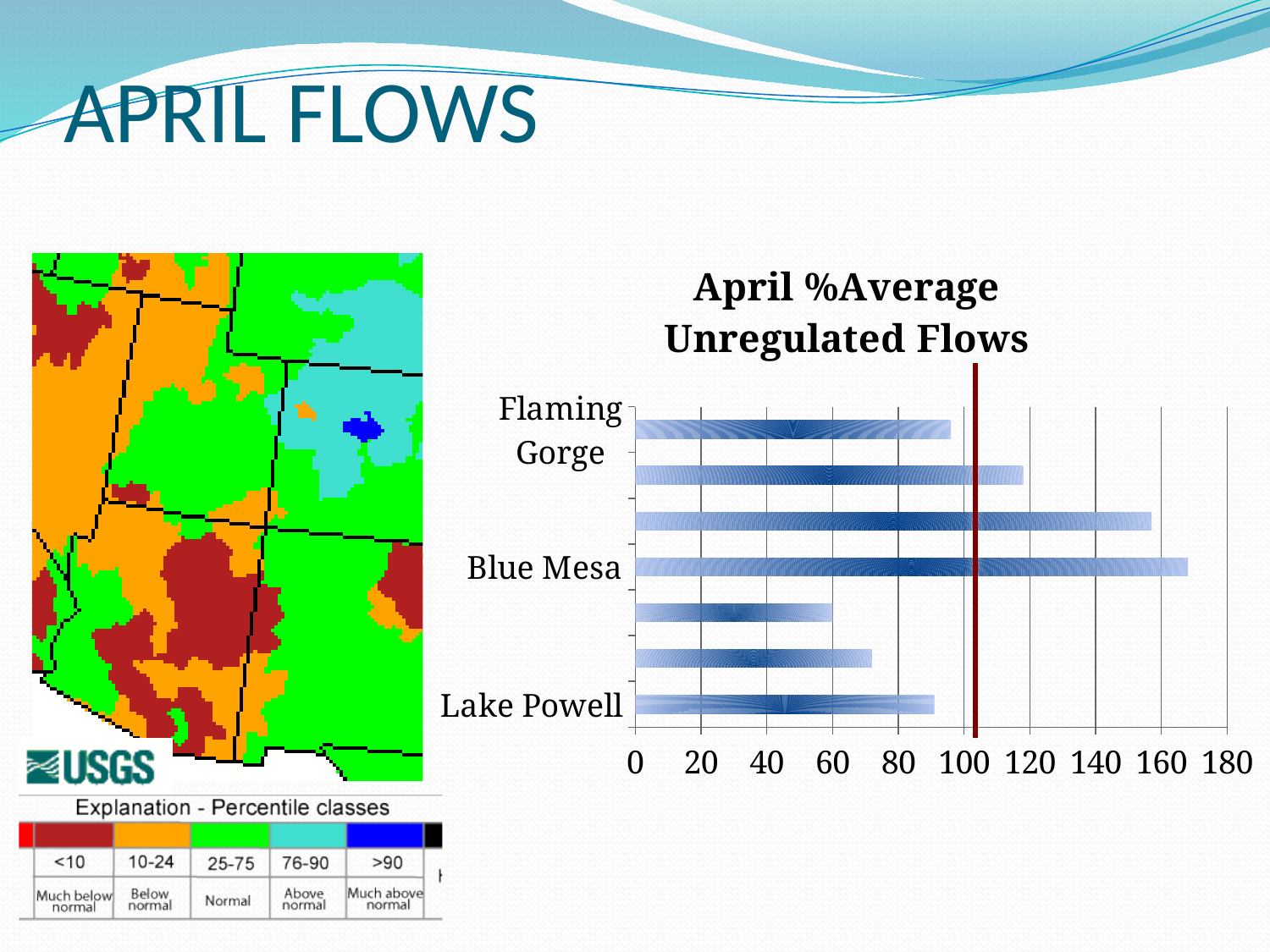
In the April %Average Unregulated Flows chart, is the value of the bar labelled Blue Mesa greater or less than 160? greater In the April %Average Unregulated Flows chart, is the value of the bar labelled Lake Powell greater or less than 80? greater What kind of chart is shown on the right side of the slide? bar chart In the April %Average Unregulated Flows chart, what is the highest value shown on the horizontal axis? 180 In the April %Average Unregulated Flows chart, which is larger: the bar labelled Blue Mesa or the bar labelled Lake Powell? Blue Mesa What is the title of the chart on the right side of the slide? April %Average Unregulated Flows In the April %Average Unregulated Flows chart, is the value of the bar labelled Lake Powell greater or less than 100? less In the April %Average Unregulated Flows chart, which labelled category has the longest bar? Blue Mesa In the April %Average Unregulated Flows chart, how many bars are plotted in total? 7 In the April %Average Unregulated Flows chart, how many category labels are shown on the vertical axis? 3